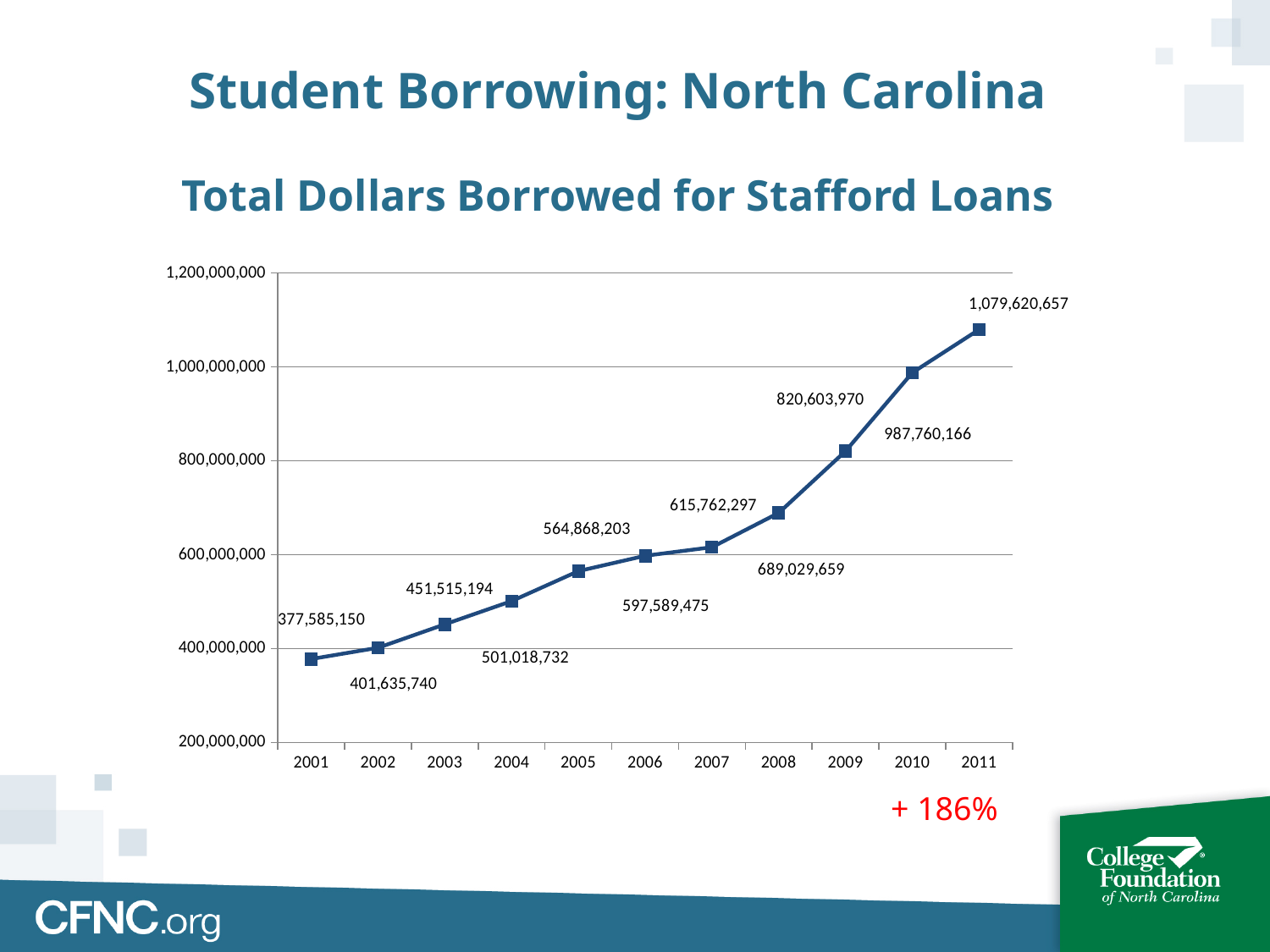
Which year has the lowest total dollars borrowed? 2001 What is the difference between the 2011 value and the 2001 value? 702,035,507 How many years are plotted on the chart? 11 Which year has the highest total dollars borrowed? 2011 Do the values rise or fall from 2001 to 2011? Rise Which year has a larger value, 2004 or 2008? 2008 What is the total dollars borrowed for Stafford Loans in 2011? 1,079,620,657 What type of chart is shown on the slide? Line chart What is the difference between the 2010 value and the 2009 value? 167,156,196 What is the value plotted for 2006? 597,589,475 What is the total dollars borrowed for Stafford Loans in 2001? 377,585,150 What is the value plotted for 2009? 820,603,970